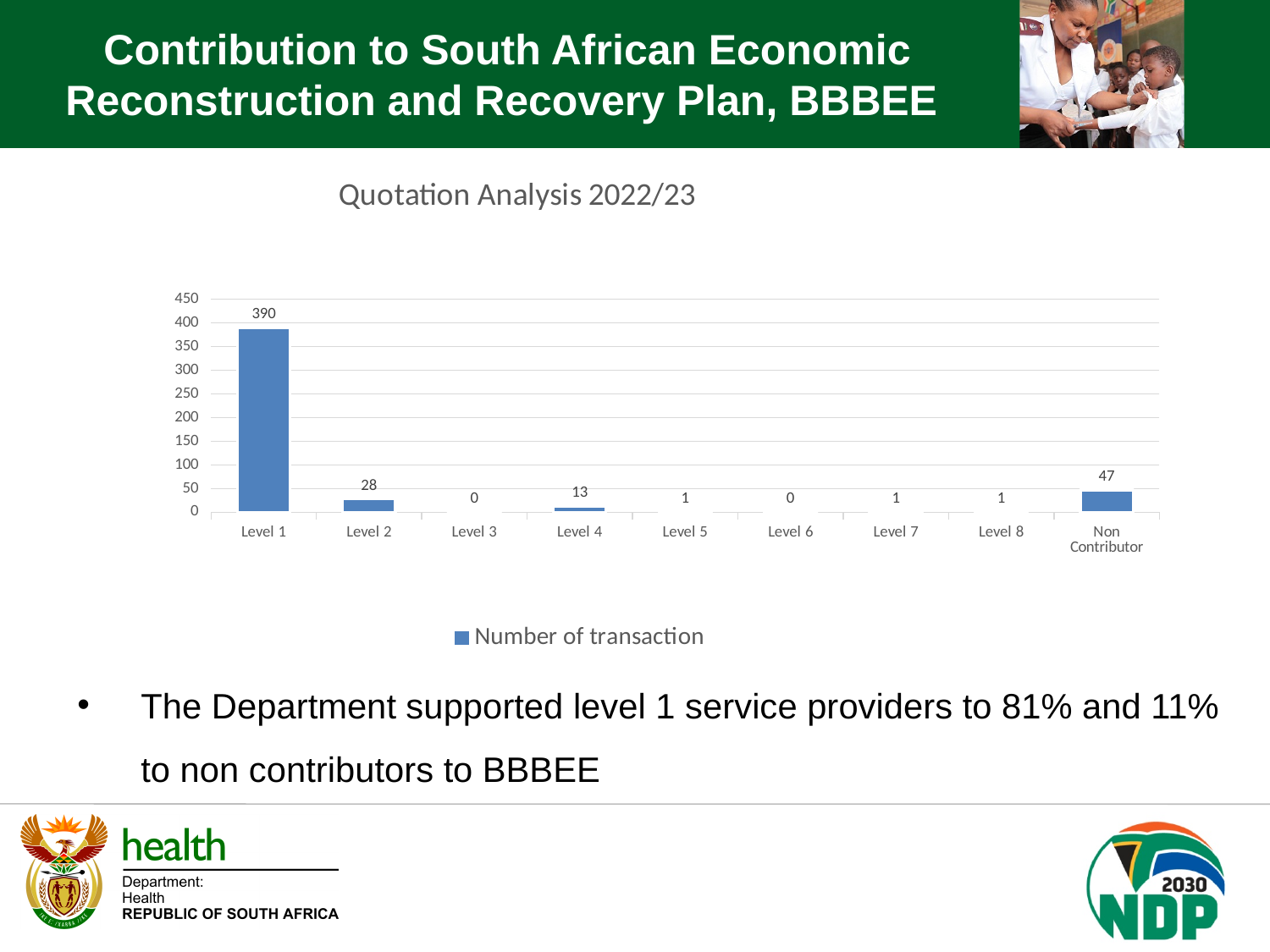
What is the number of transactions for Level 4? 13 How many series does the legend list? 1 What is the title of the chart? Quotation Analysis 2022/23 What is the number of transactions for Non Contributor? 47 Is the value for Level 1 greater or less than 350? greater Which category has the highest number of transactions? Level 1 What is the number of transactions for Level 1? 390 What is the name of the series in the legend? Number of transaction Which has more transactions, Level 2 or Level 4? Level 2 What is the difference in number of transactions between Level 1 and Non Contributor? 343 What kind of chart is shown? Bar chart How many categories are shown on the x axis? 9